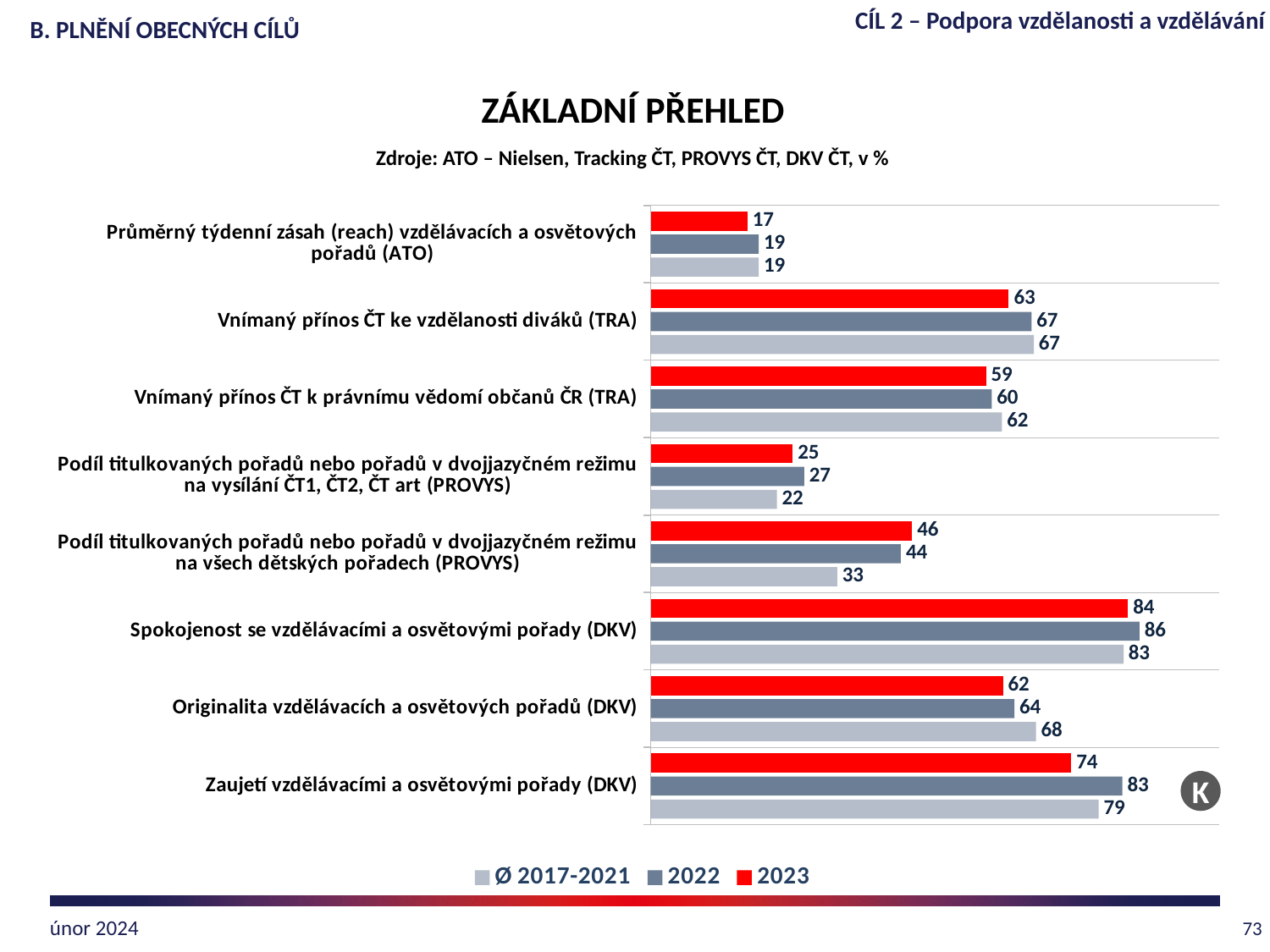
What kind of chart is shown on the slide? Bar chart For 'Originalita vzdělávacích a osvětových pořadů (DKV)', which is larger: the Ø 2017-2021 value or the 2023 value? Ø 2017-2021 What is the 2022 value for 'Zaujetí vzdělávacími a osvětovými pořady (DKV)'? 83 What is the difference between the 2022 and 2023 values for 'Zaujetí vzdělávacími a osvětovými pořady (DKV)'? 9 What is the 2023 value for 'Spokojenost se vzdělávacími a osvětovými pořady (DKV)'? 84 What is the 2023 value for 'Průměrný týdenní zásah (reach) vzdělávacích a osvětových pořadů (ATO)'? 17 Which category has the lowest 2022 value? Průměrný týdenní zásah (reach) vzdělávacích a osvětových pořadů (ATO) How many categories are shown on the chart? 8 Which category has the highest 2023 value? Spokojenost se vzdělávacími a osvětovými pořady (DKV) How many series does the legend list? 3 What is the Ø 2017-2021 value for 'Podíl titulkovaných pořadů nebo pořadů v dvojjazyčném režimu na všech dětských pořadech (PROVYS)'? 33 Which colour represents the 2023 series in the chart? Red